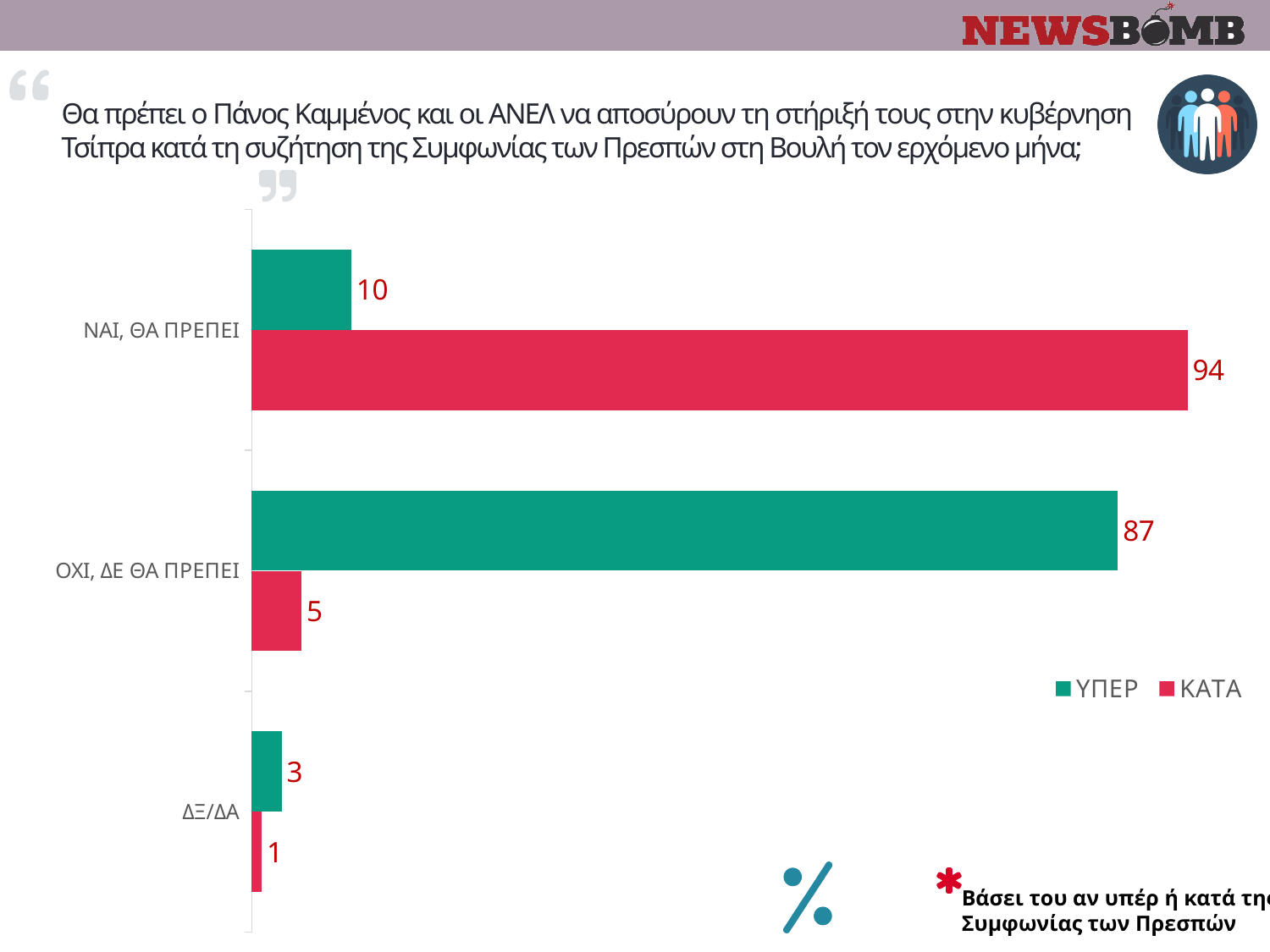
What is the value for ΥΠΕΡ in the category ΝΑΙ, ΘΑ ΠΡΕΠΕΙ? 10 Which is larger: the ΥΠΕΡ value for ΔΞ/ΔΑ or the ΚΑΤΑ value for ΟΧΙ, ΔΕ ΘΑ ΠΡΕΠΕΙ? ΚΑΤΑ value for ΟΧΙ, ΔΕ ΘΑ ΠΡΕΠΕΙ What is the value for ΚΑΤΑ in the category ΝΑΙ, ΘΑ ΠΡΕΠΕΙ? 94 Which category has the lowest value for the ΚΑΤΑ series? ΔΞ/ΔΑ What is the value for ΥΠΕΡ in the category ΟΧΙ, ΔΕ ΘΑ ΠΡΕΠΕΙ? 87 What kind of chart is shown on the slide? Bar chart What is the difference between the ΚΑΤΑ and ΥΠΕΡ values in the category ΝΑΙ, ΘΑ ΠΡΕΠΕΙ? 84 What is the value for ΚΑΤΑ in the category ΔΞ/ΔΑ? 1 How many series does the legend list? 2 Which category has the highest value for the ΥΠΕΡ series? ΟΧΙ, ΔΕ ΘΑ ΠΡΕΠΕΙ How many categories are shown on the chart? 3 What is the difference between the ΥΠΕΡ and ΚΑΤΑ values in the category ΟΧΙ, ΔΕ ΘΑ ΠΡΕΠΕΙ? 82